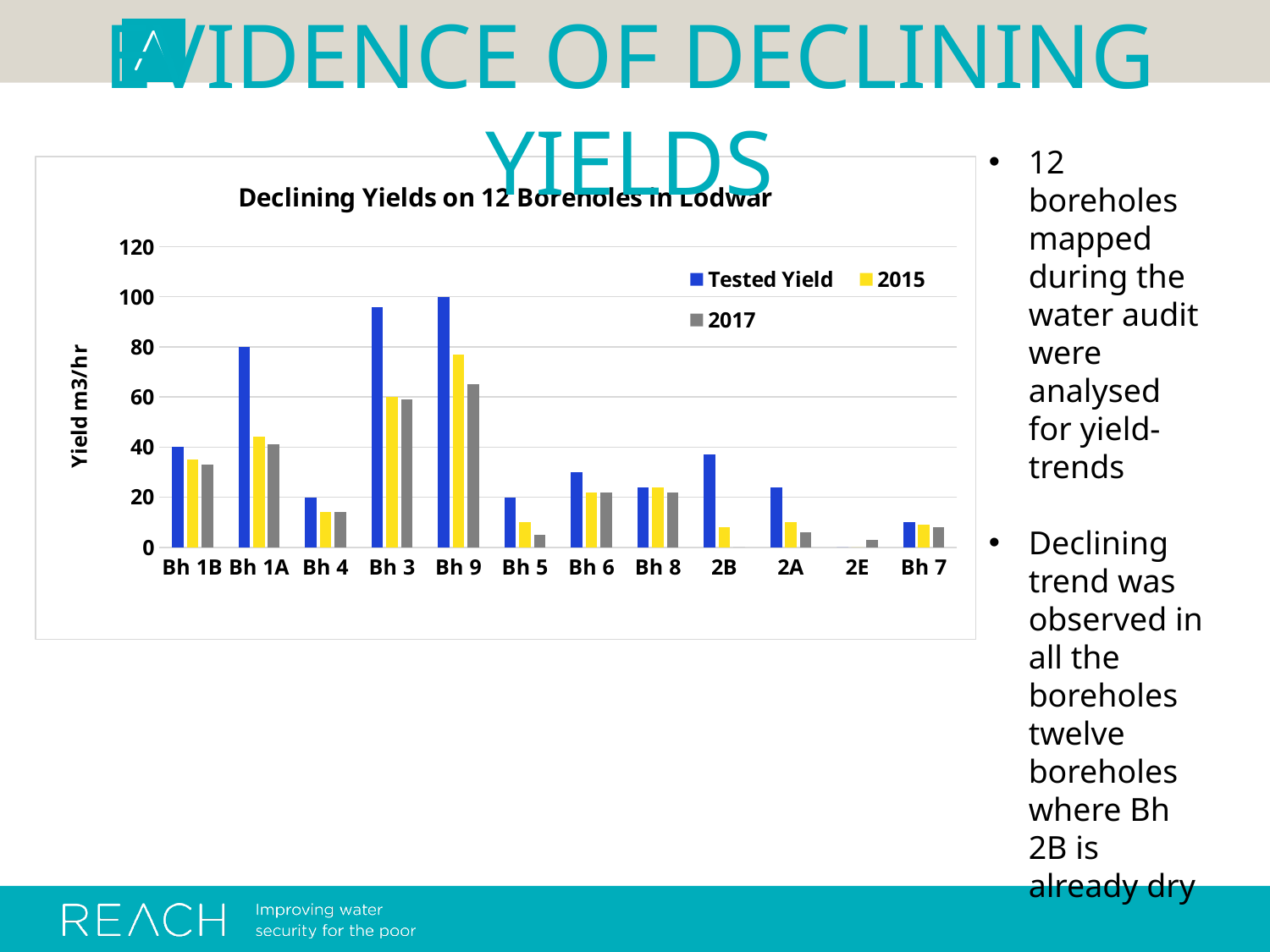
What is the Tested Yield for Bh 9? 100 Is the Tested Yield for Bh 3 greater or less than 80? greater Which borehole has the highest Tested Yield in the chart? Bh 9 How many boreholes (categories) are shown on the x axis of the chart? 12 What type of chart is shown on the slide? bar chart How many series does the chart legend list? 3 What is the label of the y axis of the chart? Yield m3/hr What is the title of the chart? Declining Yields on 12 Boreholes in Lodwar What is the Tested Yield for Bh 1A? 80 Is the 2017 value for Bh 9 greater or less than 60? greater Is the 2015 value for Bh 5 greater or less than 20? less Which is larger for Bh 2B: the Tested Yield or the 2015 value? Tested Yield